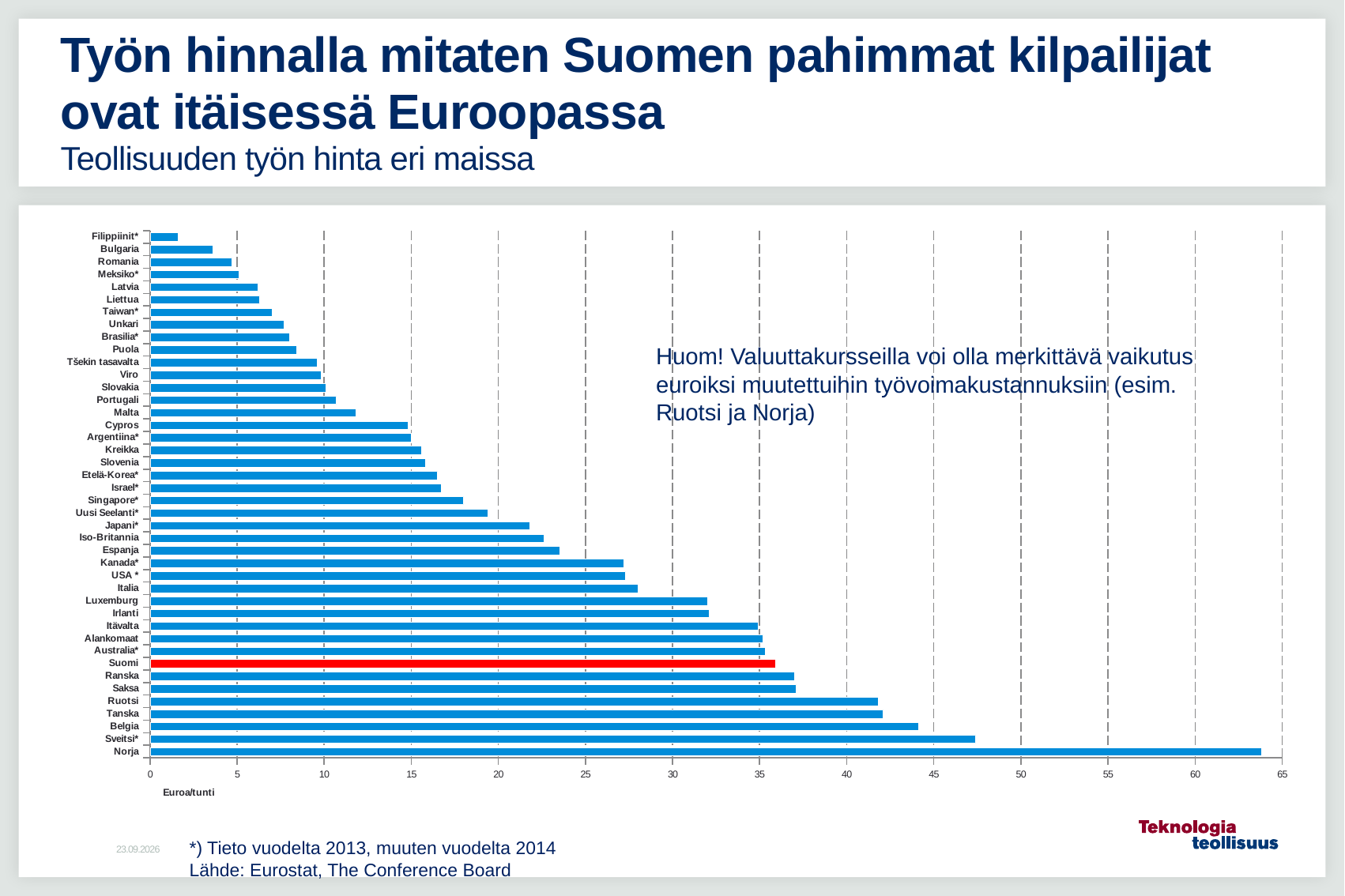
Is the value for Sveitsi* greater or less than 50? less How many countries are listed in the chart? 42 Is the value for Bulgaria greater or less than 5? less Is the value for Belgia greater or less than 40? greater Which country has the highest value in the chart? Norja What unit is shown on the x axis of the chart? Euroa/tunti What kind of chart is shown on the slide? bar chart Which has the larger value, Italia or Espanja? Italia Which bar is highlighted in red in the chart? Suomi Which country has the lowest value in the chart? Filippiinit*